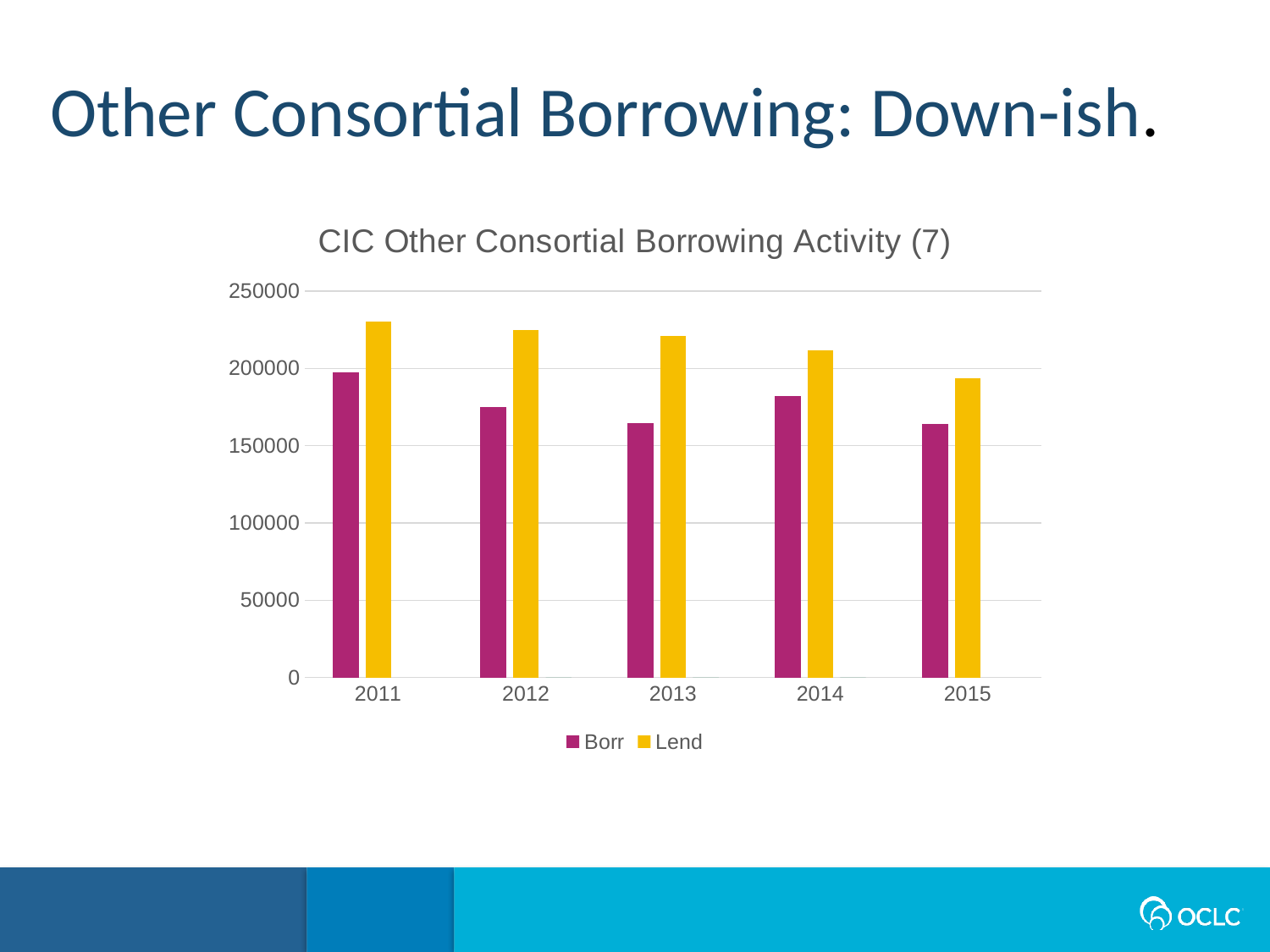
How many series does the legend list? 2 Which year has the lowest Lend value? 2015 Which year has the highest Borr value? 2011 What is the title of the chart? CIC Other Consortial Borrowing Activity (7) Is the Lend value for 2015 greater or less than 200000? less Do the Lend values rise or fall from 2011 to 2015? Fall Is the Lend value for 2011 greater or less than 200000? greater How many years are shown on the x axis? 5 What kind of chart is shown on the slide? Bar chart Is the Borr value for 2013 greater or less than 150000? greater Which is larger, the Borr value for 2011 or the Borr value for 2015? 2011 In 2013, which is larger, Borr or Lend? Lend